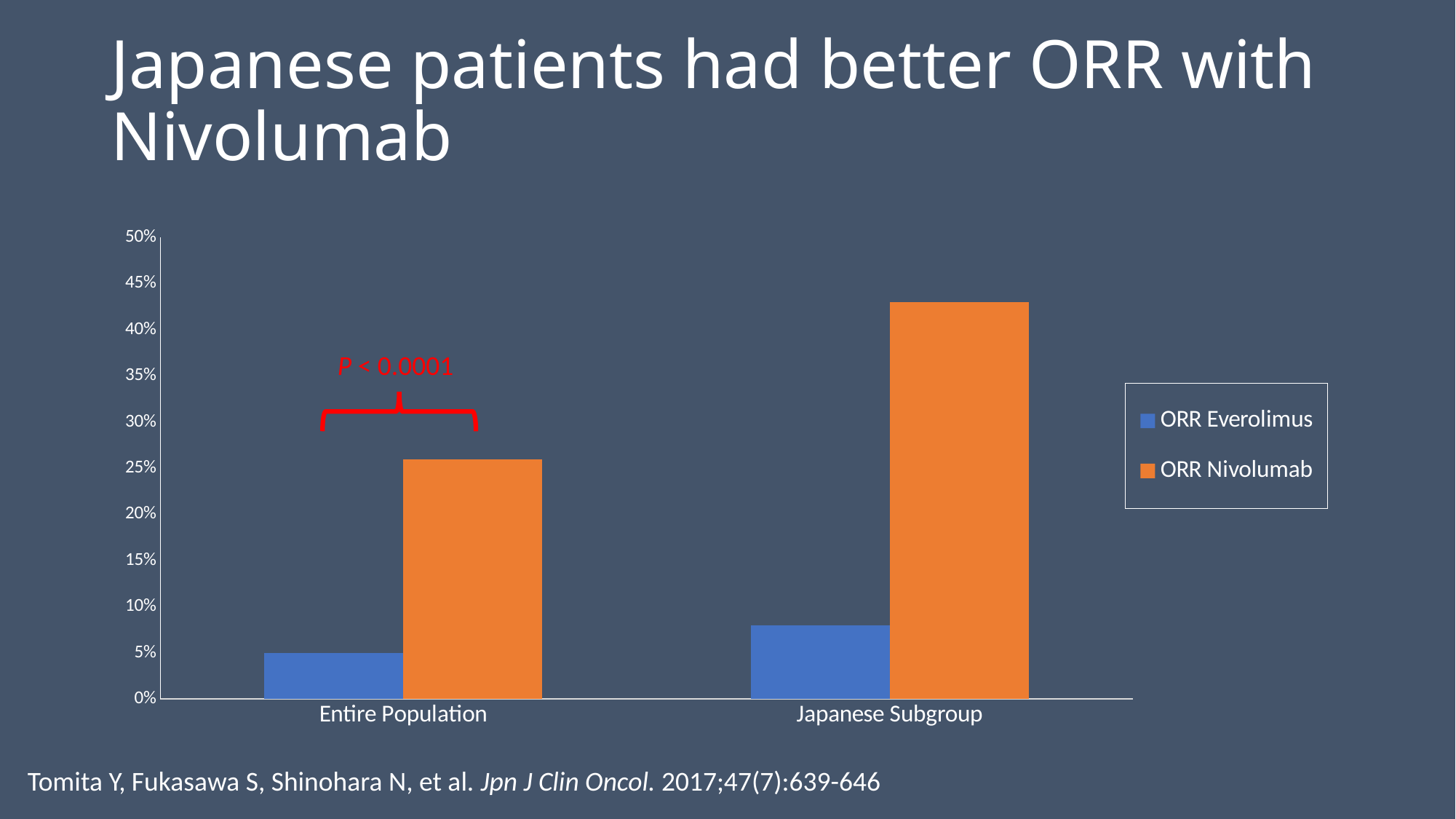
Is the ORR Nivolumab value for the Entire Population greater or less than 30%? less Is the ORR Nivolumab value for the Japanese Subgroup greater or less than 40%? greater How many series does the legend list? 2 Is the ORR Everolimus value for the Japanese Subgroup greater or less than 10%? less What kind of chart is shown on the slide? bar chart How many categories are shown on the x axis? 2 Which category has the higher ORR Nivolumab value, Entire Population or Japanese Subgroup? Japanese Subgroup Which is larger for the Japanese Subgroup, ORR Everolimus or ORR Nivolumab? ORR Nivolumab Which series is shown in orange? ORR Nivolumab Which bar is the shortest in the chart? ORR Everolimus for Entire Population Which bar is the tallest in the chart? ORR Nivolumab for Japanese Subgroup What P value is annotated above the Entire Population bars? P < 0.0001